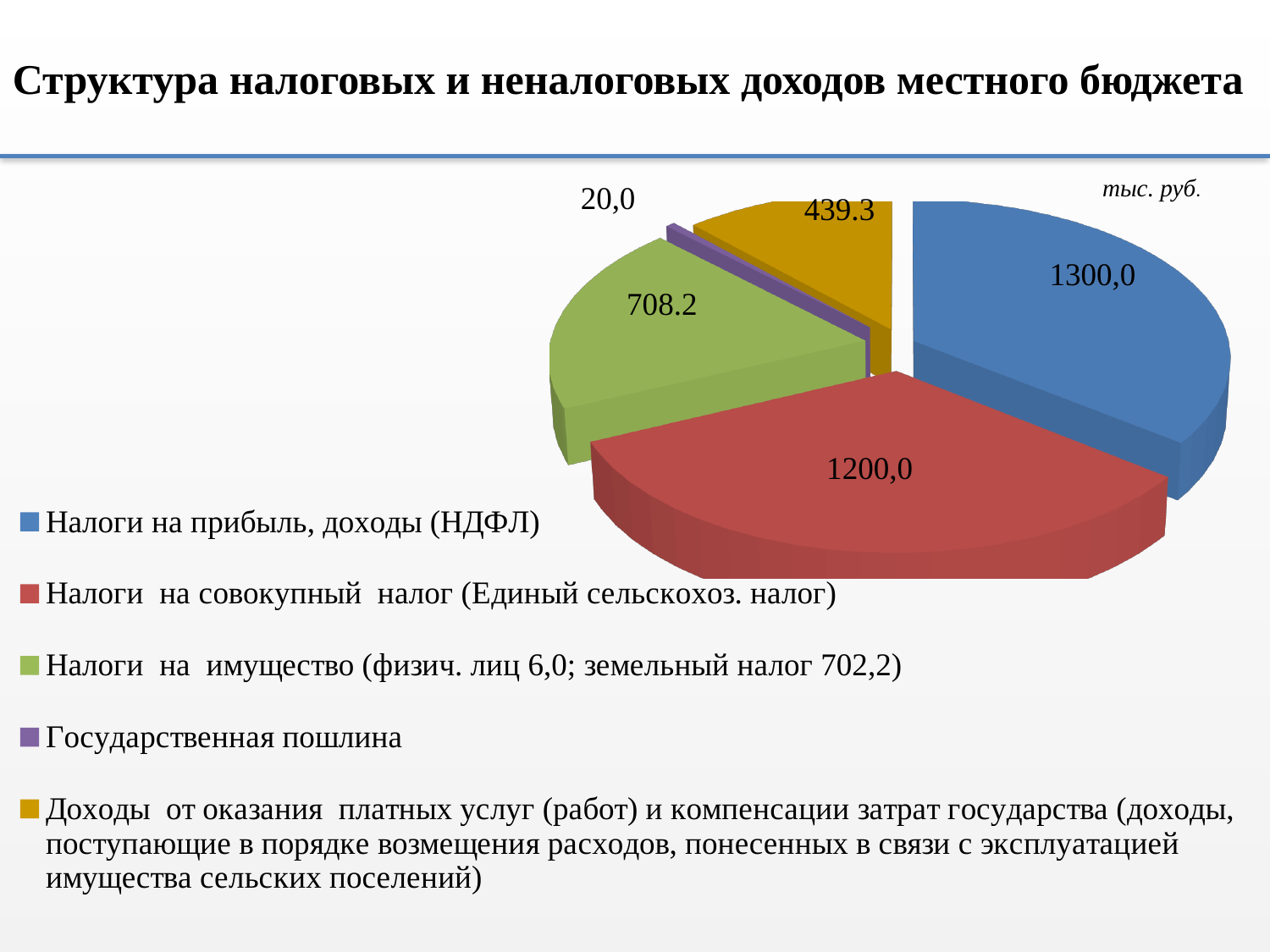
What is the value for Налоги на совокупный налог (Единый сельскохоз. налог)? 1200,0 What is the difference between the values for Налоги на прибыль, доходы (НДФЛ) and Налоги на совокупный налог (Единый сельскохоз. налог)? 100,0 What is the value for Государственная пошлина? 20,0 How many slices does the pie chart have? 5 What is the value for Доходы от оказания платных услуг (работ) и компенсации затрат государства? 439.3 What is the value for Налоги на прибыль, доходы (НДФЛ)? 1300,0 What unit is indicated for the values in the chart? тыс. руб. Which category has the smallest slice of the pie? Государственная пошлина What is the difference between the values for Налоги на имущество and Доходы от оказания платных услуг? 268.9 What type of chart is shown on the slide? Pie chart Which is larger: the value for Налоги на имущество or the value for Доходы от оказания платных услуг? Налоги на имущество Which category has the largest slice of the pie? Налоги на прибыль, доходы (НДФЛ)